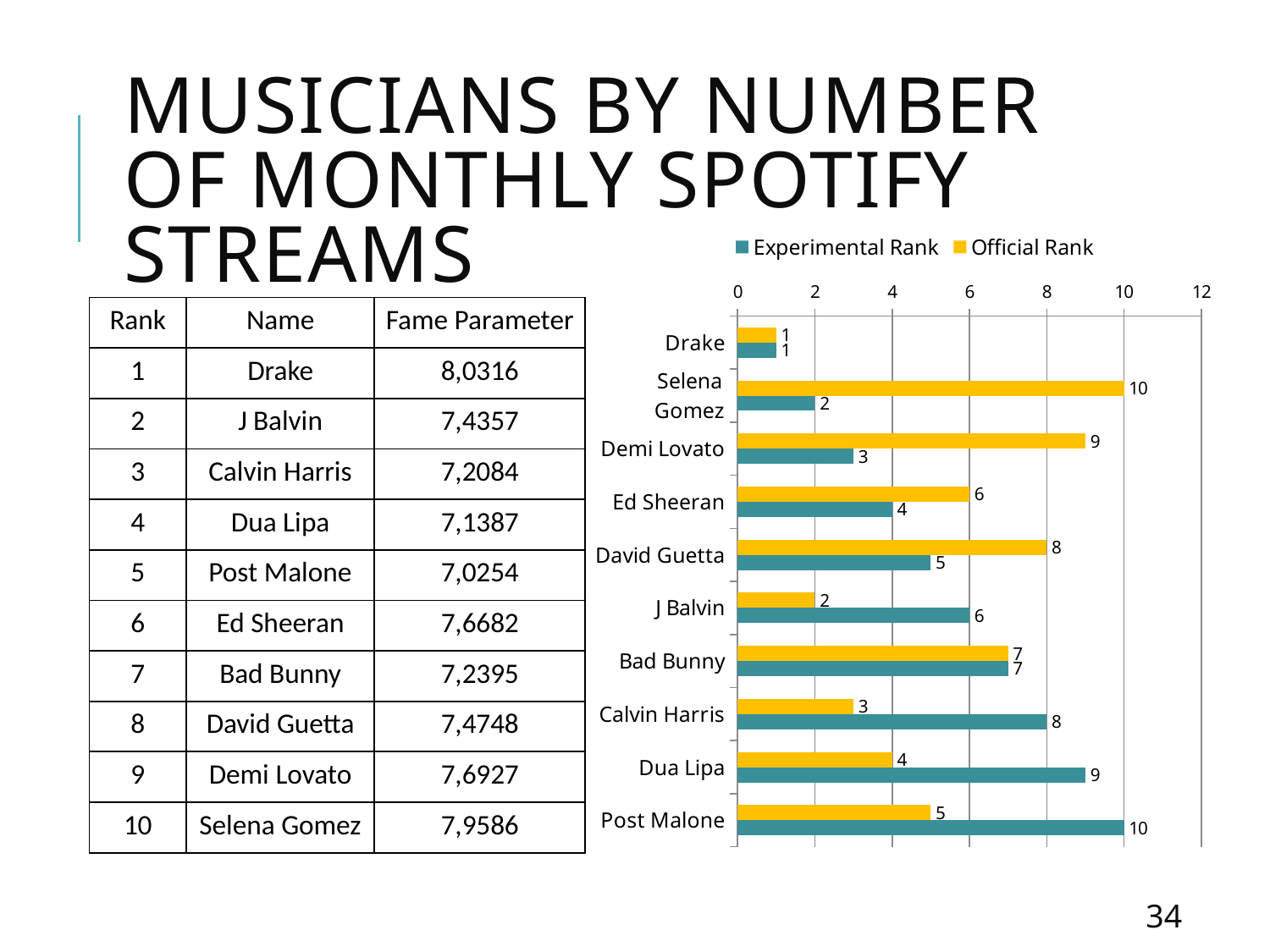
Which musician has the same value for Experimental Rank and Official Rank at 7? Bad Bunny For Dua Lipa, which is larger: the Experimental Rank or the Official Rank? Experimental Rank Which musician has the lowest Official Rank value? Drake Which musician has the highest Experimental Rank value? Post Malone What is the Official Rank for J Balvin? 2 Which colour represents the Official Rank series in the chart? Yellow What is the difference between the Official Rank and the Experimental Rank for Selena Gomez? 8 How many series does the chart legend list? 2 What is the Official Rank for Selena Gomez? 10 What is the Experimental Rank for Calvin Harris? 8 What kind of chart is shown on the slide? Bar chart How many musicians are shown in the chart? 10